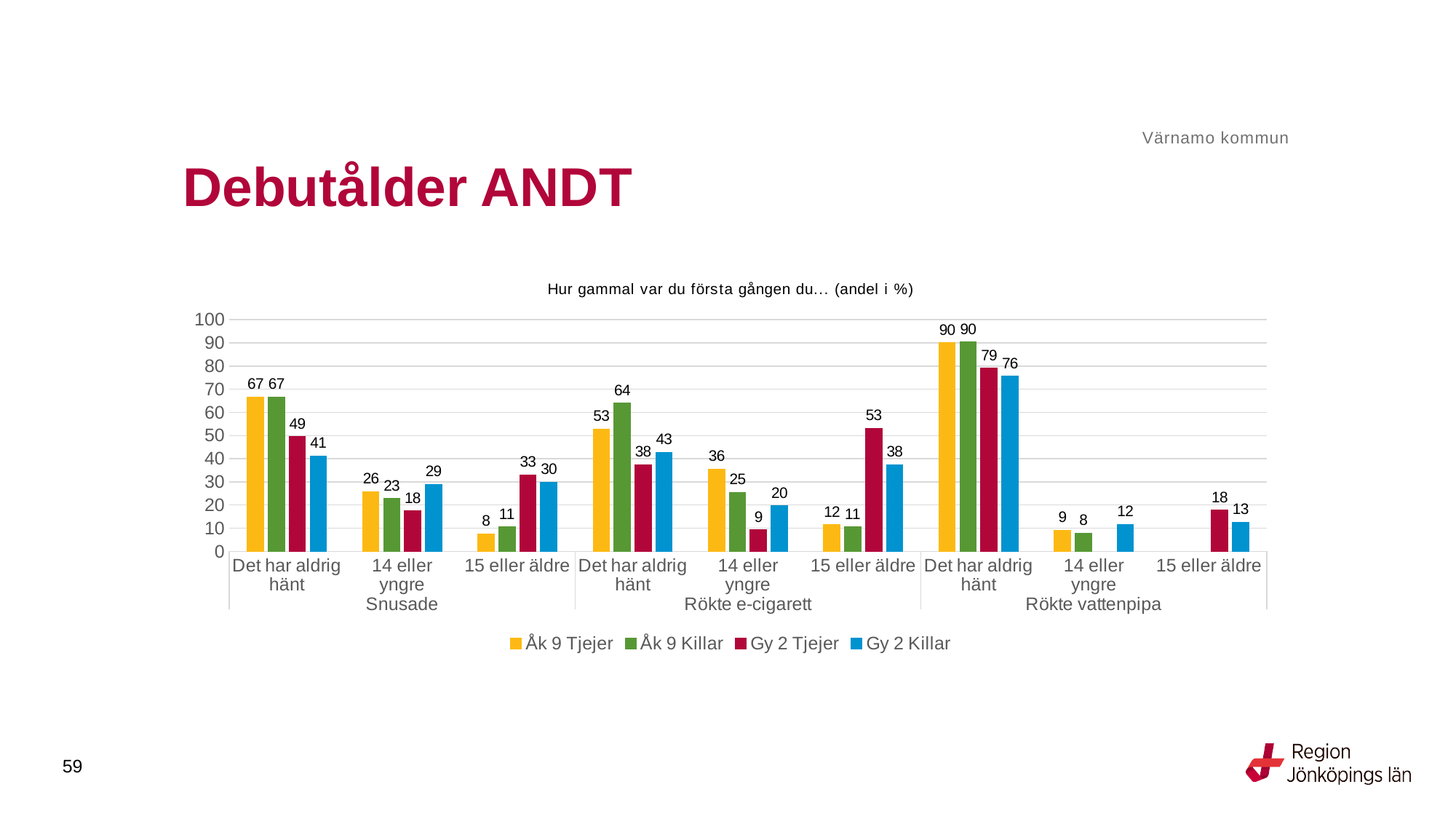
What is the title of the chart? Hur gammal var du första gången du… (andel i %) What is the value for Gy 2 Tjejer for 'Det har aldrig hänt' under Snusade? 49 What type of chart is shown on the slide? bar chart Which series has the lowest value for '14 eller yngre' under Rökte e-cigarett? Gy 2 Tjejer What is the difference between Åk 9 Tjejer and Gy 2 Killar for 'Det har aldrig hänt' under Snusade? 26 Is the value for Gy 2 Tjejer for 'Det har aldrig hänt' under Rökte vattenpipa greater or less than 70? greater How many series does the legend list? 4 Which series has the highest value for '15 eller äldre' under Rökte e-cigarett? Gy 2 Tjejer What is the value for Åk 9 Killar for 'Det har aldrig hänt' under Rökte e-cigarett? 64 What is the value for Gy 2 Killar for '14 eller yngre' under Rökte vattenpipa? 12 Which is larger for '15 eller äldre' under Snusade: Gy 2 Tjejer or Gy 2 Killar? Gy 2 Tjejer What is the difference between Åk 9 Tjejer and Åk 9 Killar for '14 eller yngre' under Rökte e-cigarett? 11